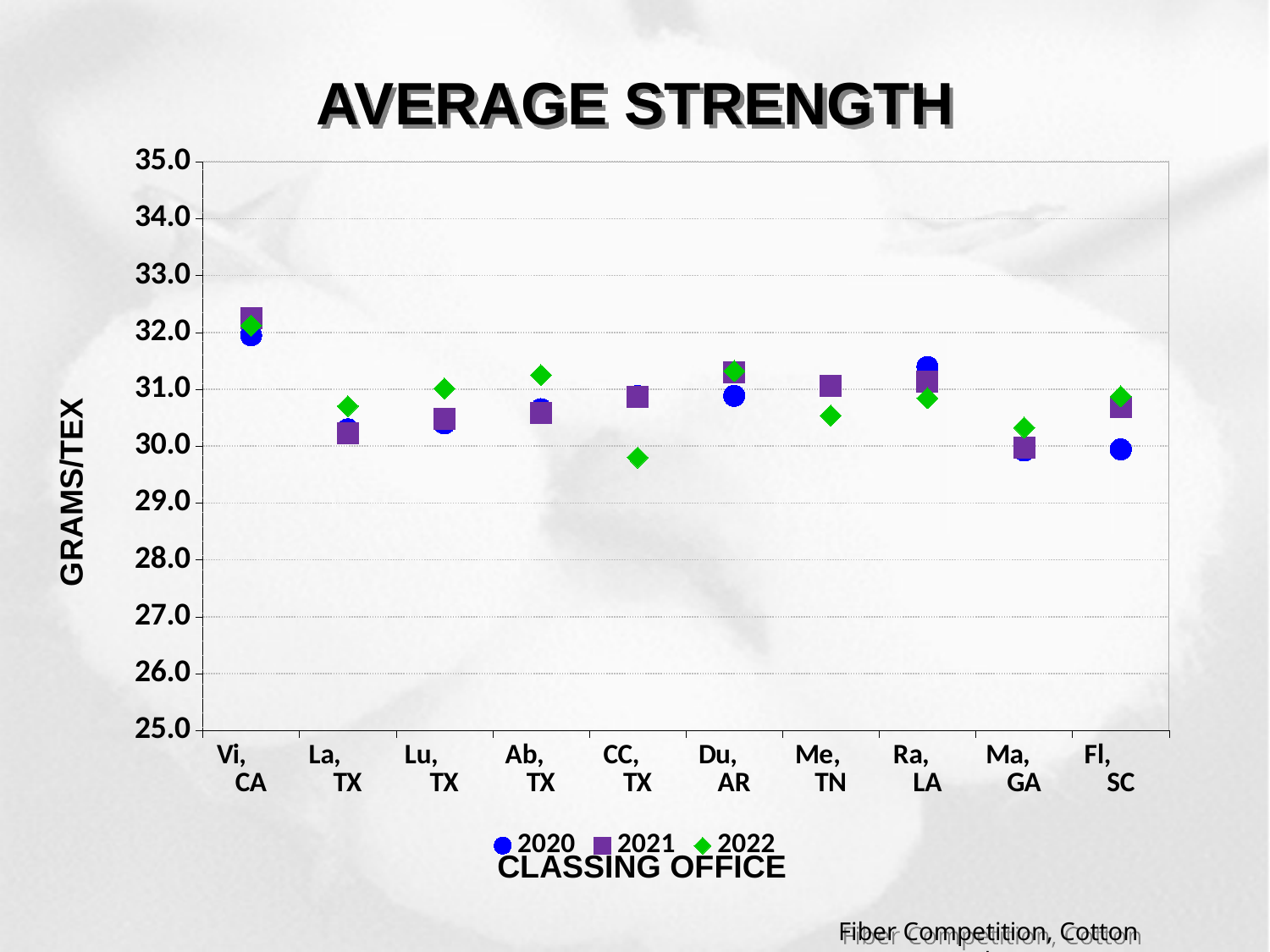
What kind of chart is shown on the slide? Scatter chart Is the 2022 value for Ab, TX greater or less than 31.0? greater Is the 2021 value for Vi, CA greater or less than 32.0? greater Which classing office has the highest 2021 average strength? Vi, CA How many series does the legend list? 3 At CC, TX, which series has the larger value, 2021 or 2022? 2021 At Fl, SC, which series has the larger value, 2020 or 2022? 2022 Which classing office has the lowest 2022 average strength? CC, TX How many classing offices are shown on the x axis? 10 Which classing office has the highest 2022 average strength? Vi, CA What is the title of the vertical axis? GRAMS/TEX Is the 2022 value for CC, TX greater or less than 30.0? less